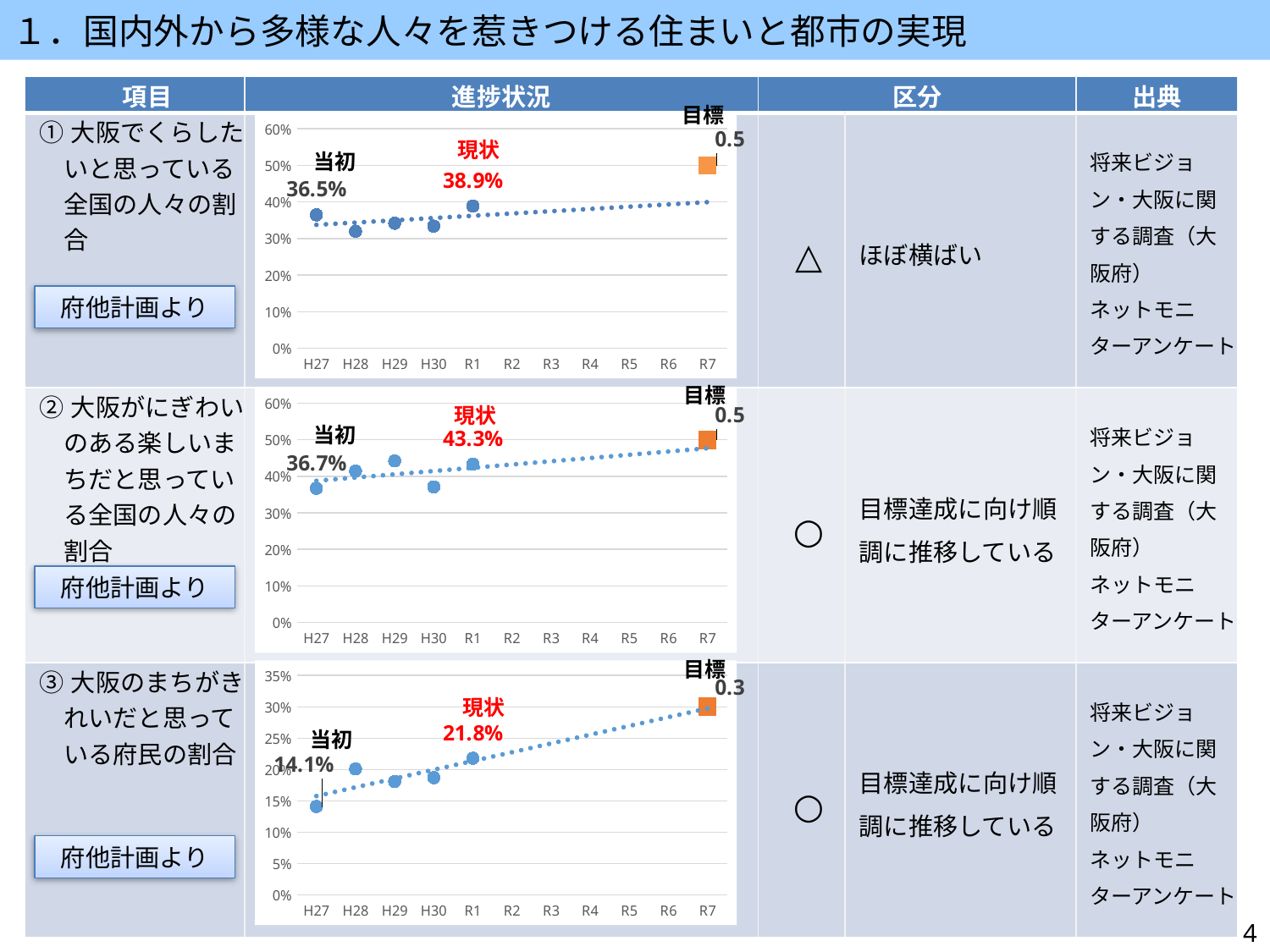
In the middle chart, by how much does the 現状 value exceed the 当初 value? 6.6 percentage points In the bottom chart, what is the difference between the 現状 value (21.8%) and the 当初 value (14.1%)? 7.7 percentage points In the bottom chart, do the plotted values generally rise or fall from H27 to R1? rise In the top chart (① 大阪でくらしたいと思っている全国の人々の割合), what is the 当初 (initial) value? 36.5% In the bottom chart (③ 大阪のまちがきれいだと思っている府民の割合), what is the 目標 value? 0.3 In the middle chart, what is the 当初 value? 36.7% In the middle chart (② 大阪がにぎわいのある楽しいまちだと思っている全国の人々の割合), what is the 現状 value? 43.3% In the top chart, which is larger, the 当初 value or the 現状 value? 現状 (38.9%) In the top chart, is the value for H28 greater or less than 40%? less How many x-axis labels (years) are shown on the bottom chart? 11 In the top chart, what is the 目標 (target) value shown at R7? 0.5 In the top chart, what is the 現状 (current) value? 38.9%